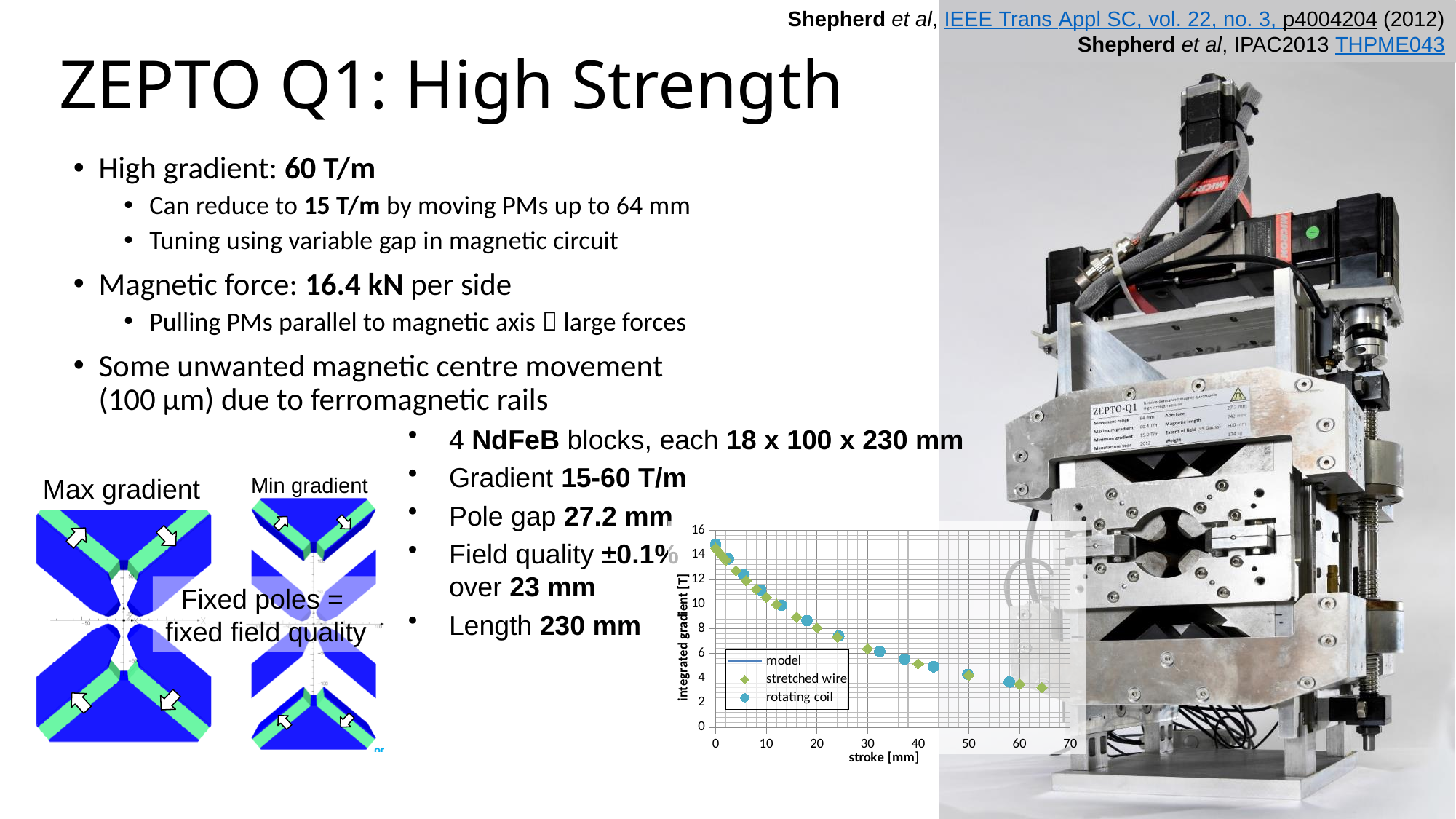
What kind of chart is shown at the bottom of the slide? scatter chart Is the integrated gradient at a stroke of 30 mm greater or less than 8 T? less Is the integrated gradient at a stroke of 50 mm greater or less than 6 T? less Is the integrated gradient at a stroke of 0 mm greater or less than 12 T? greater What is the label of the x axis of the integrated gradient chart? stroke [mm] What are the three series named in the legend of the integrated gradient chart? model, stretched wire, rotating coil How many series does the legend of the integrated gradient chart list? 3 Which stroke value has the higher integrated gradient, 0 mm or 60 mm? 0 mm Does the integrated gradient rise or fall as the stroke increases? fall What is the maximum value shown on the y axis of the integrated gradient chart? 16